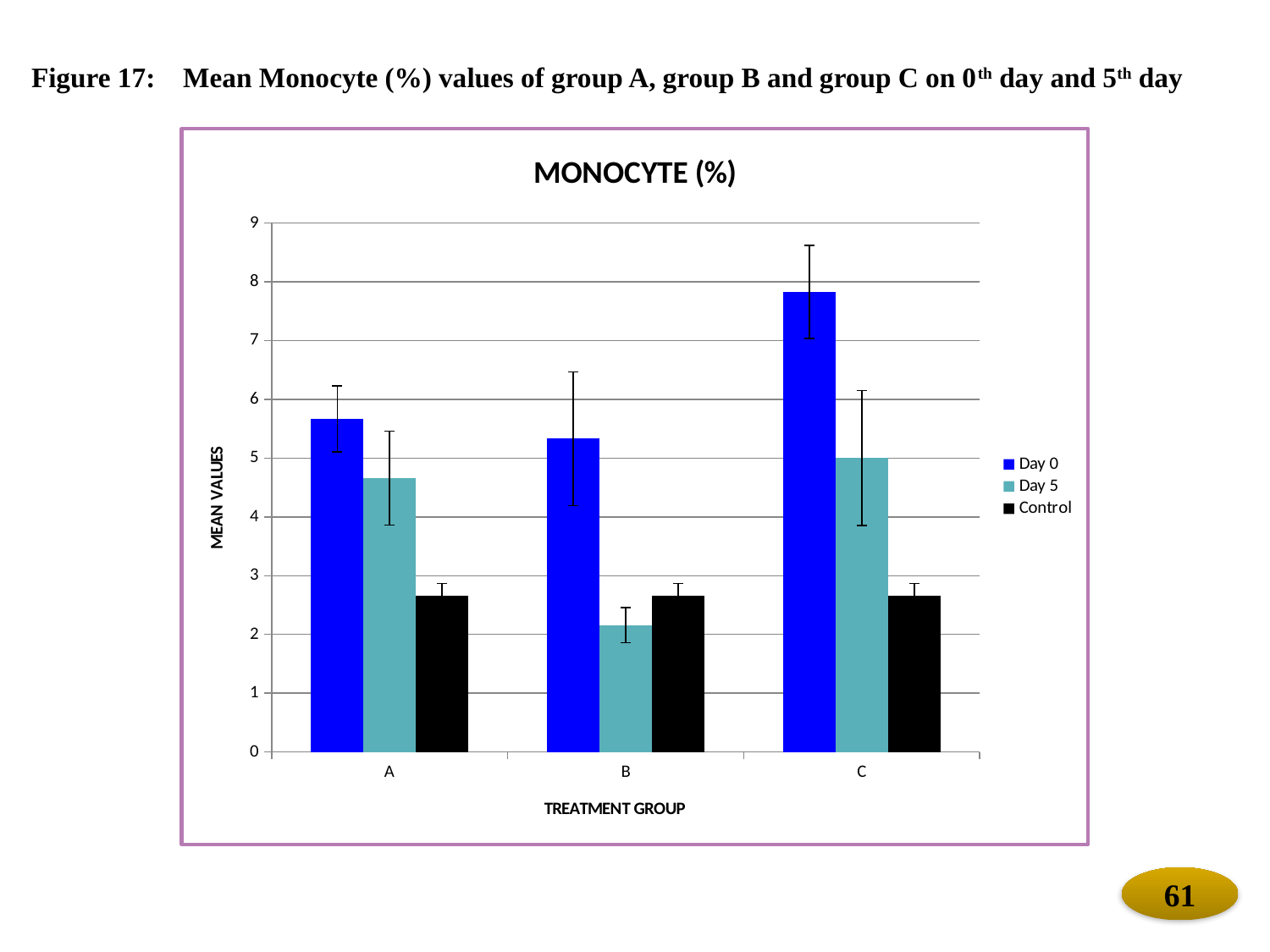
What is the label of the y axis? MEAN VALUES Which treatment group has the lowest Day 5 value? B What kind of chart is shown on the slide? bar chart How many treatment groups are shown on the x axis? 3 How many series does the legend list? 3 Is the Day 0 value for group A greater or less than 5? greater Which treatment group has the highest Day 0 value? C For group B, which is larger, the Day 5 value or the Control value? Control Is the Day 0 value for group C greater or less than 7? greater For group A, which is larger, the Day 0 value or the Day 5 value? Day 0 Is the Day 5 value for group B greater or less than 3? less What is the title of the chart? MONOCYTE (%)